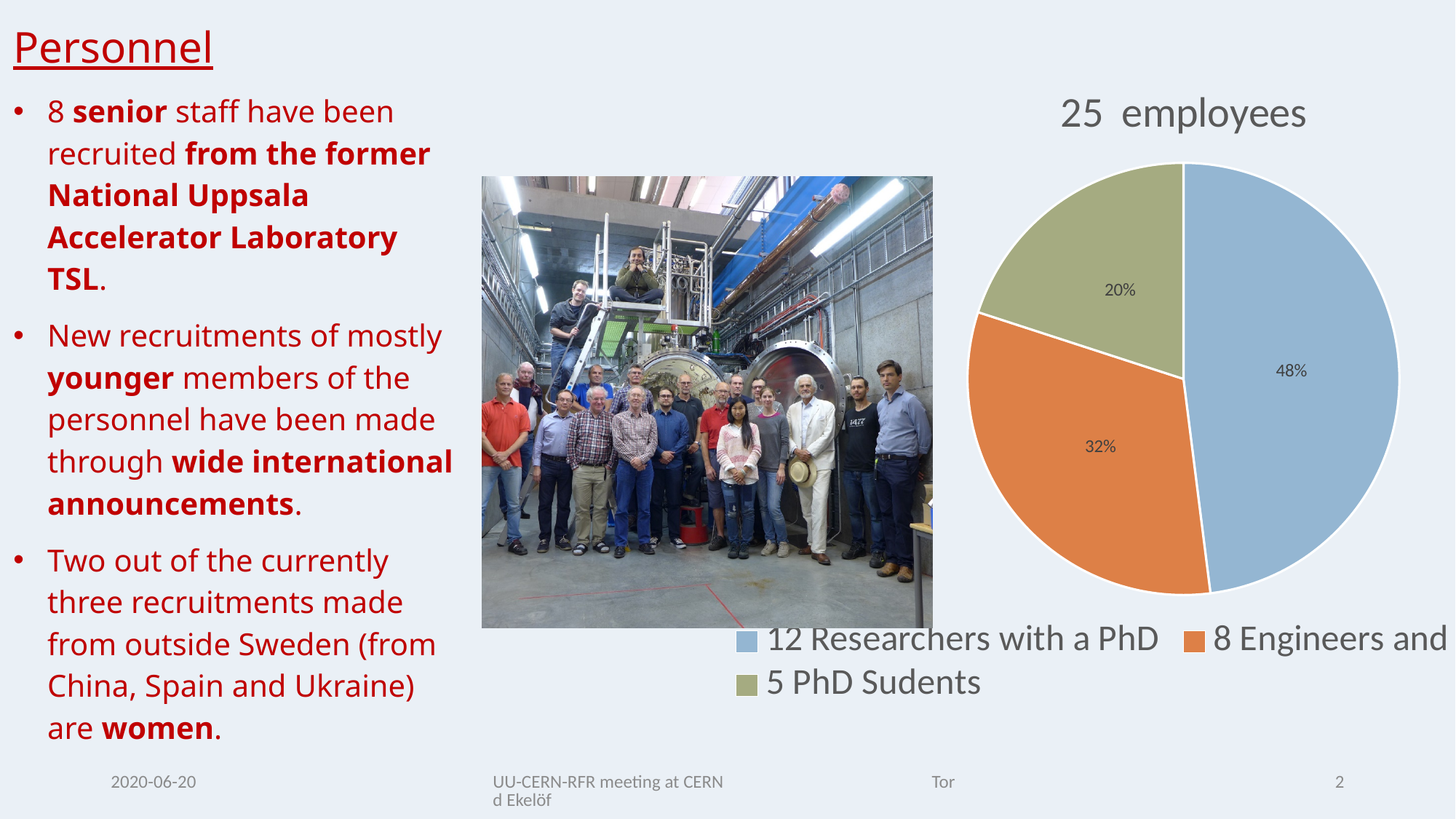
Which is larger: the share of Engineers or the share of PhD Students? Engineers What percentage of employees are PhD Students? 20% How many slices does the pie chart have? 3 Which group makes up the smallest share of employees? 5 PhD Sudents How many entries does the legend list? 3 What type of chart is shown on the slide? Pie chart What is the difference in percentage points between the Researchers with a PhD slice and the PhD Students slice? 28 What colour is the slice for Researchers with a PhD? Blue What percentage does the orange slice (Engineers) represent? 32% What is the title of the pie chart? 25 employees Which group makes up the largest share of employees? 12 Researchers with a PhD What percentage of employees are Researchers with a PhD? 48%